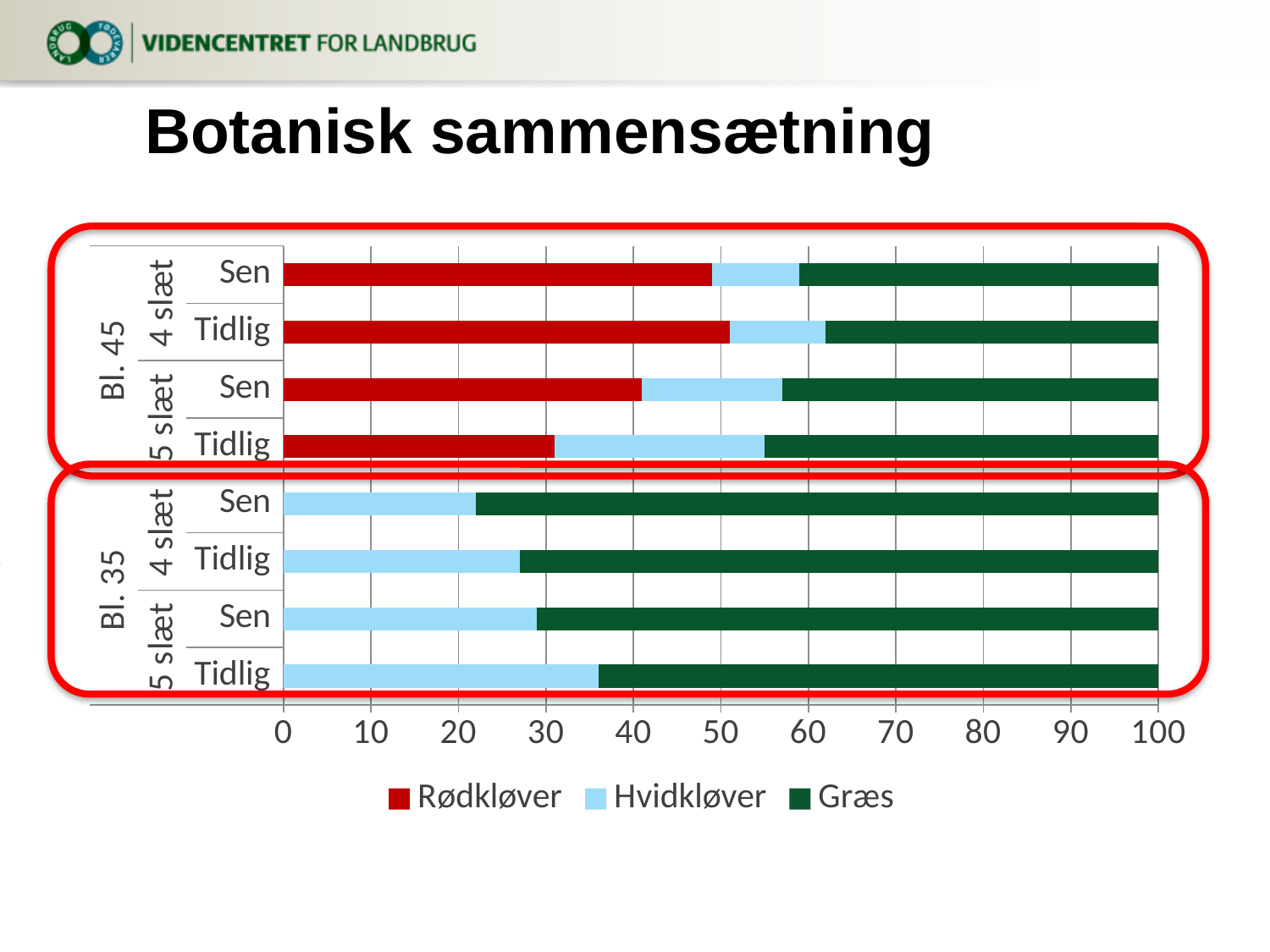
Within Bl. 45, 5 slæt, which has the larger Rødkløver segment: Sen or Tidlig? Sen What kind of chart is shown on the slide? Stacked bar chart Among the Bl. 35 bars, which has the largest Hvidkløver segment? 5 slæt, Tidlig Is the Hvidkløver value for Bl. 35, 4 slæt, Sen greater or less than 30? less Among the Bl. 45 bars, which has the smallest Rødkløver segment? 5 slæt, Tidlig What is the title of the chart on the slide? Botanisk sammensætning Is the Hvidkløver value for Bl. 35, 5 slæt, Tidlig greater or less than 30? greater How many series does the legend list? 3 Which series from the legend does not appear in the Bl. 35 bars? Rødkløver Is the Rødkløver value for Bl. 45, 5 slæt, Tidlig greater or less than 40? less How many bars are plotted in the chart? 8